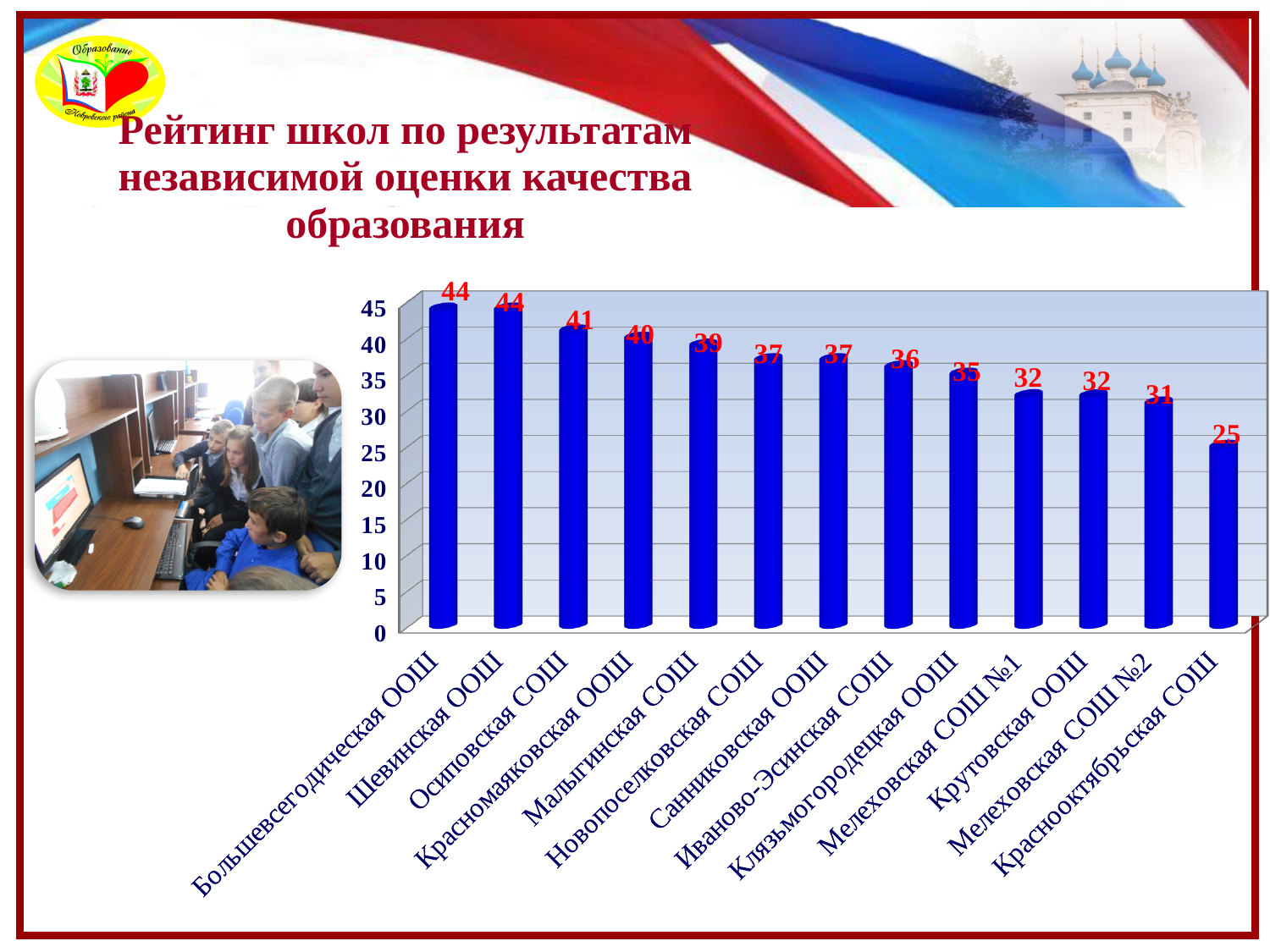
What value is shown for Малыгинская СОШ? 39 What is the difference between the values for Шевинская ООШ and Краснооктябрьская СОШ? 19 Which school has the lowest value in the chart? Краснооктябрьская СОШ What is the highest value shown in the chart? 44 What value is shown for Мелеховская СОШ №2? 31 Do the values rise or fall from left to right along the x axis? Fall What value is shown for Краснооктябрьская СОШ? 25 What value is shown for Осиповская СОШ? 41 What kind of chart is shown on the slide? Bar chart What is the difference between the values for Красномаяковская ООШ and Клязьмогородецкая ООШ? 5 Which has a larger value, Иваново-Эсинская СОШ or Крутовская ООШ? Иваново-Эсинская СОШ How many schools are shown in the chart? 13